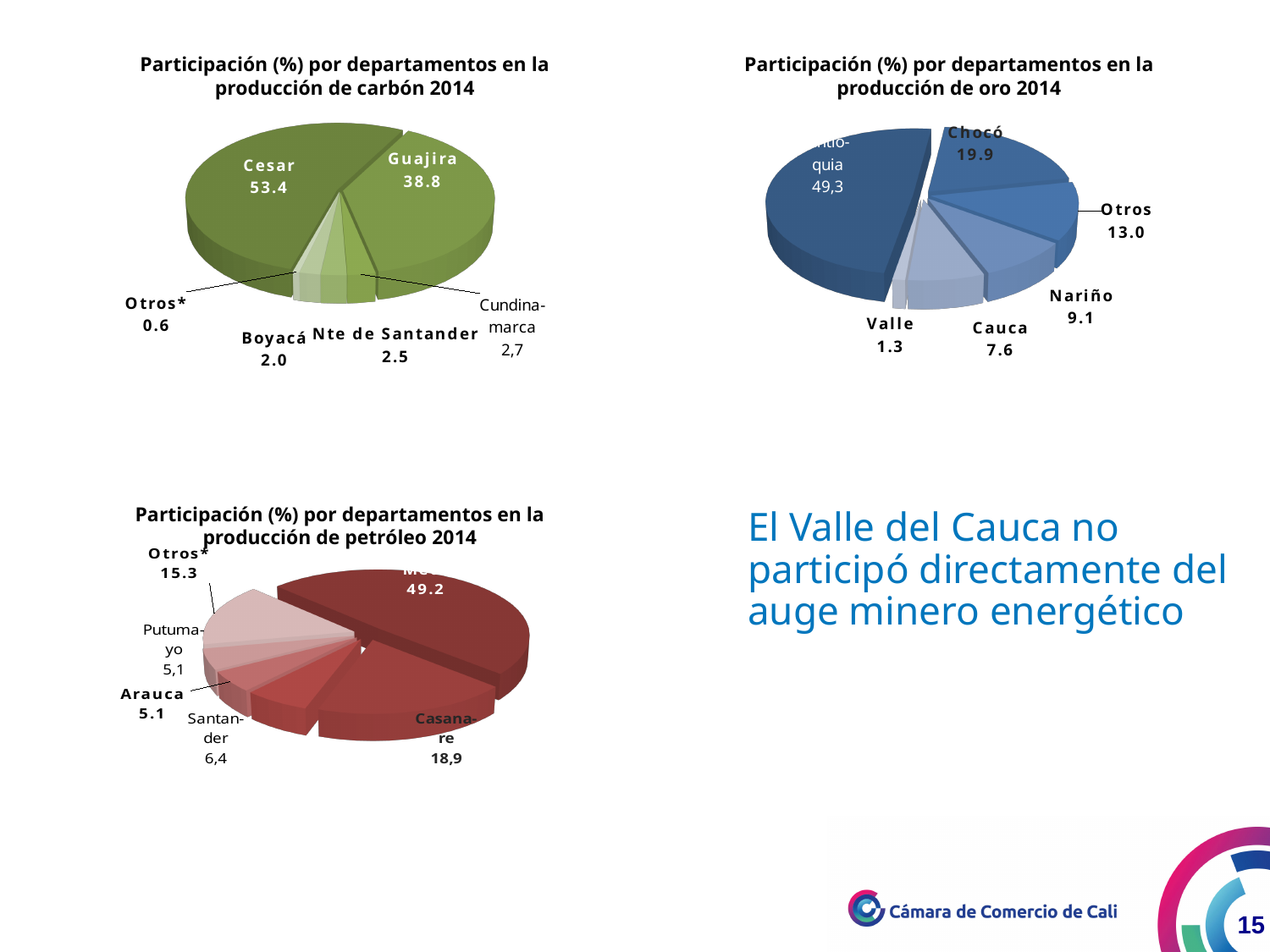
In the chart 'Participación (%) por departamentos en la producción de carbón 2014', which category has the smallest share? Otros* In the chart 'Participación (%) por departamentos en la producción de carbón 2014', what is the difference between the values for Cesar and Guajira? 14.6 In the chart 'Participación (%) por departamentos en la producción de carbón 2014', what is the value for Cesar? 53.4 How many slices does the chart 'Participación (%) por departamentos en la producción de oro 2014' have? 6 How many slices does the chart 'Participación (%) por departamentos en la producción de carbón 2014' have? 6 What kind of chart is 'Participación (%) por departamentos en la producción de petróleo 2014'? Pie chart In the chart 'Participación (%) por departamentos en la producción de oro 2014', what is the value for Valle? 1.3 In the chart 'Participación (%) por departamentos en la producción de oro 2014', which is larger, Nariño or Cauca? Nariño In the chart 'Participación (%) por departamentos en la producción de petróleo 2014', what is the value for Otros*? 15.3 In the chart 'Participación (%) por departamentos en la producción de petróleo 2014', what is the value for Casanare? 18,9 In the chart 'Participación (%) por departamentos en la producción de oro 2014', what is the value for Chocó? 19.9 In the chart 'Participación (%) por departamentos en la producción de carbón 2014', which department has the largest share? Cesar